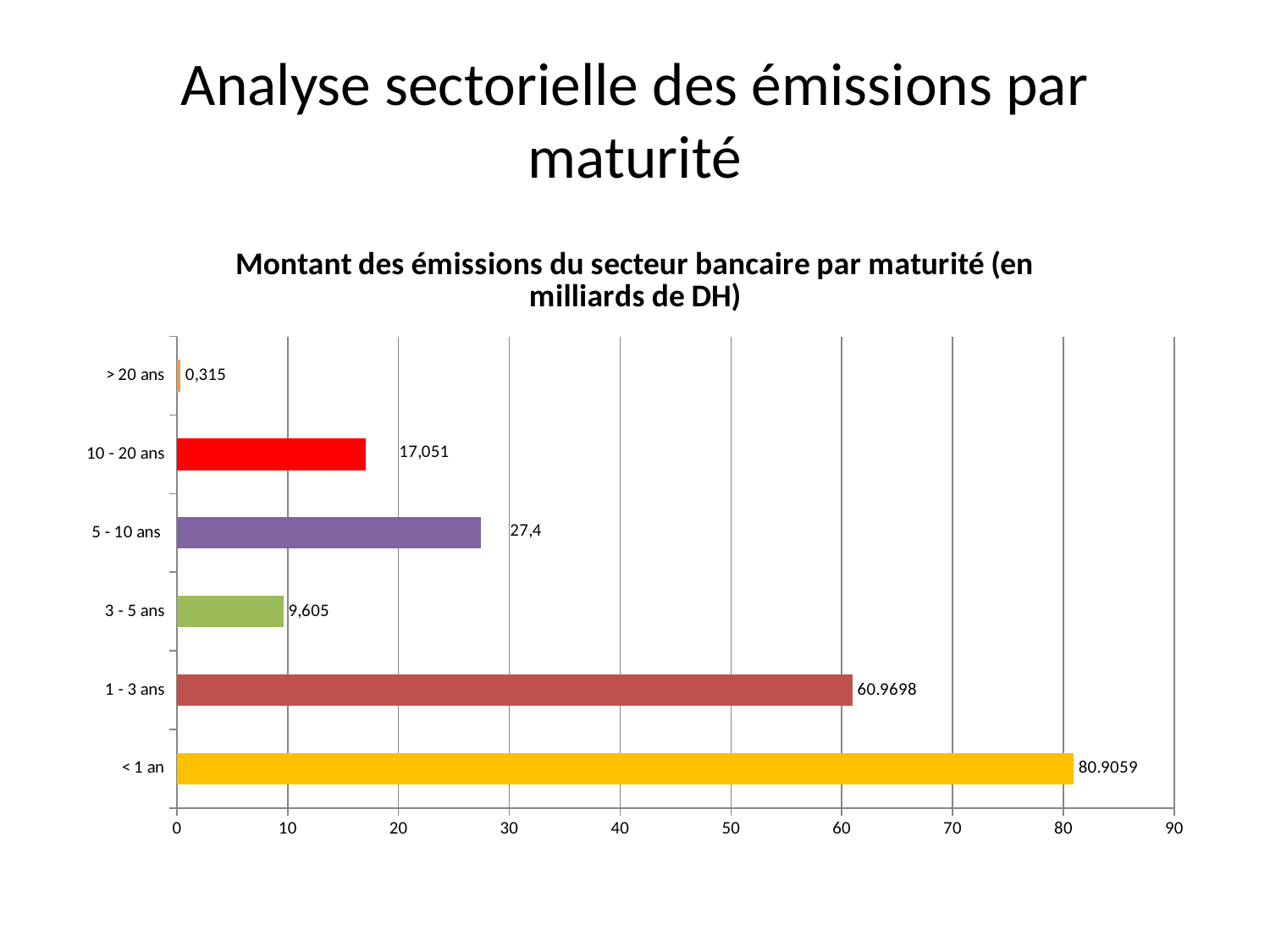
Which is larger, the value for '3 - 5 ans' or the value for '10 - 20 ans'? 10 - 20 ans What is the value for the '10 - 20 ans' maturity? 17,051 Which maturity has the highest amount of emissions? < 1 an Which maturity has the lowest amount of emissions? > 20 ans What is the value for the '5 - 10 ans' maturity? 27,4 What is the value for the '< 1 an' maturity? 80.9059 Is the value for '1 - 3 ans' greater or less than 50? greater What is the value for the '> 20 ans' maturity? 0,315 What is the difference between the values for '5 - 10 ans' and '10 - 20 ans'? 10,349 What is the difference between the values for '< 1 an' and '1 - 3 ans'? 19.9361 What kind of chart is shown on the slide? bar chart How many maturity categories are shown in the chart? 6